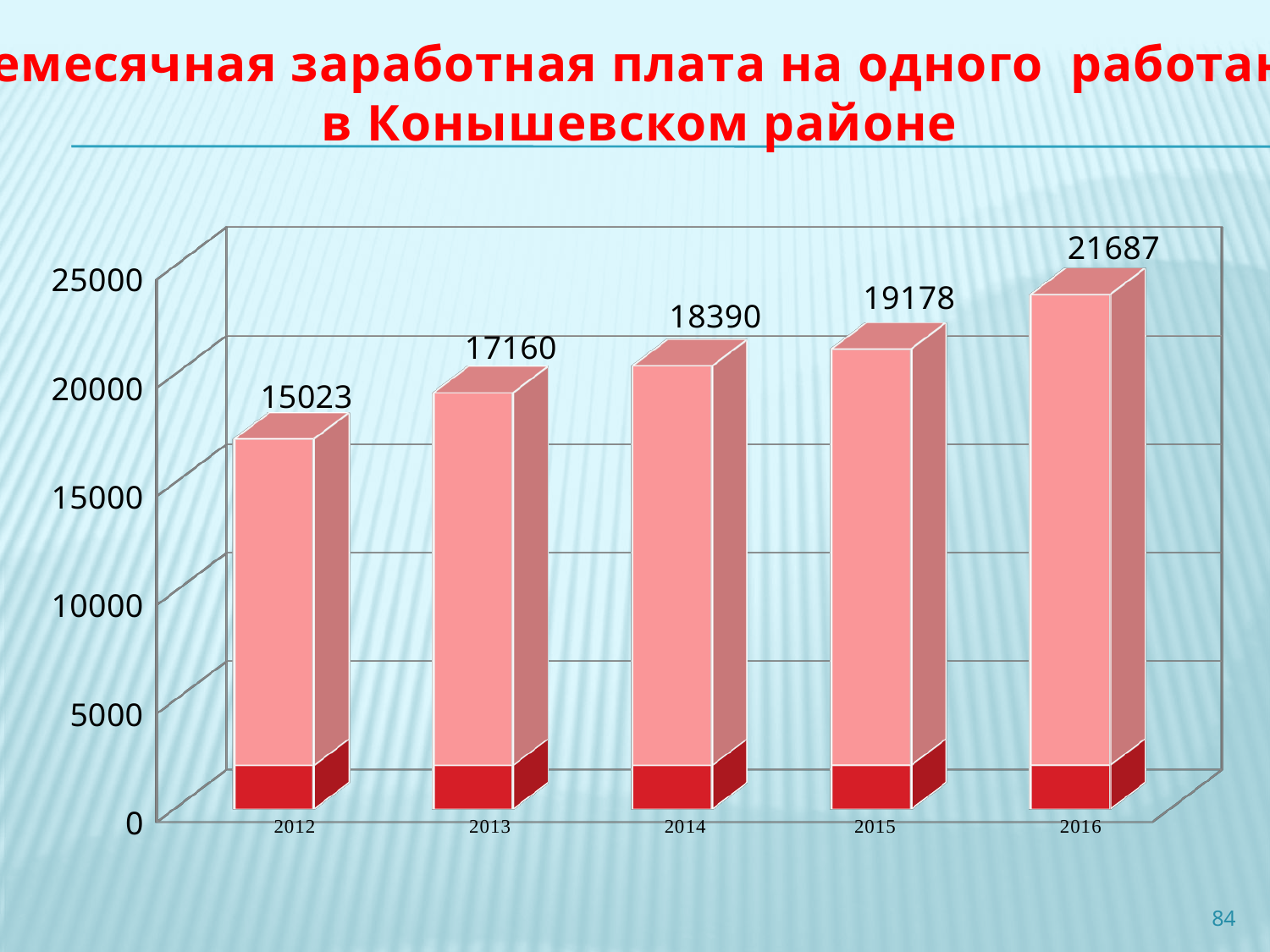
Which year has the highest value? 2016 Is the value for 2016 greater or less than 20000? greater Which is larger, the value for 2013 or the value for 2015? 2015 How many years are shown on the x axis? 5 What is the value shown for 2014? 18390 What is the value shown for 2016? 21687 Do the values rise or fall from 2012 to 2016? rise What kind of chart is shown on the slide? bar chart Which year has the lowest value? 2012 What is the difference between the values for 2015 and 2014? 788 What is the difference between the values for 2016 and 2012? 6664 What is the value shown for 2012? 15023